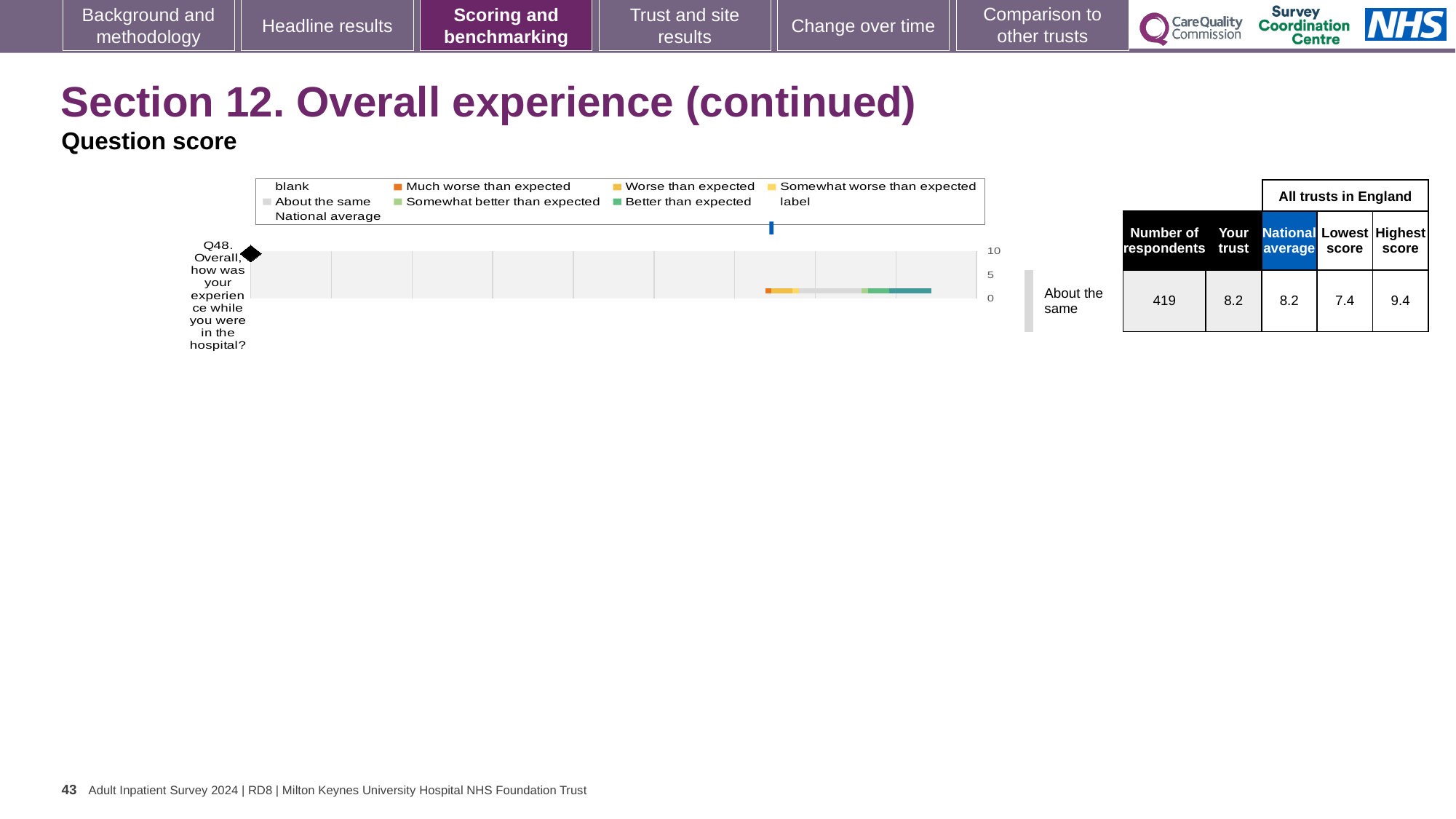
Which question is plotted in the question score chart? Q48. Overall, how was your experience while you were in the hospital? What is the lowest score among all trusts in England for Q48? 7.4 Is the trust's Q48 score higher than, lower than, or the same as the national average? the same Which benchmark category is the trust's Q48 score placed in? About the same How many questions are plotted in the question score chart? 1 How many respondents answered Q48? 419 What is the difference between the highest and lowest scores for Q48 across all trusts in England? 2.0 What is the 'Your trust' score for Q48? 8.2 What is the highest score among all trusts in England for Q48? 9.4 What kind of chart is used to show the Q48 question score? bar chart What is the national average score for Q48? 8.2 How many entries does the legend of the question score chart list? 9